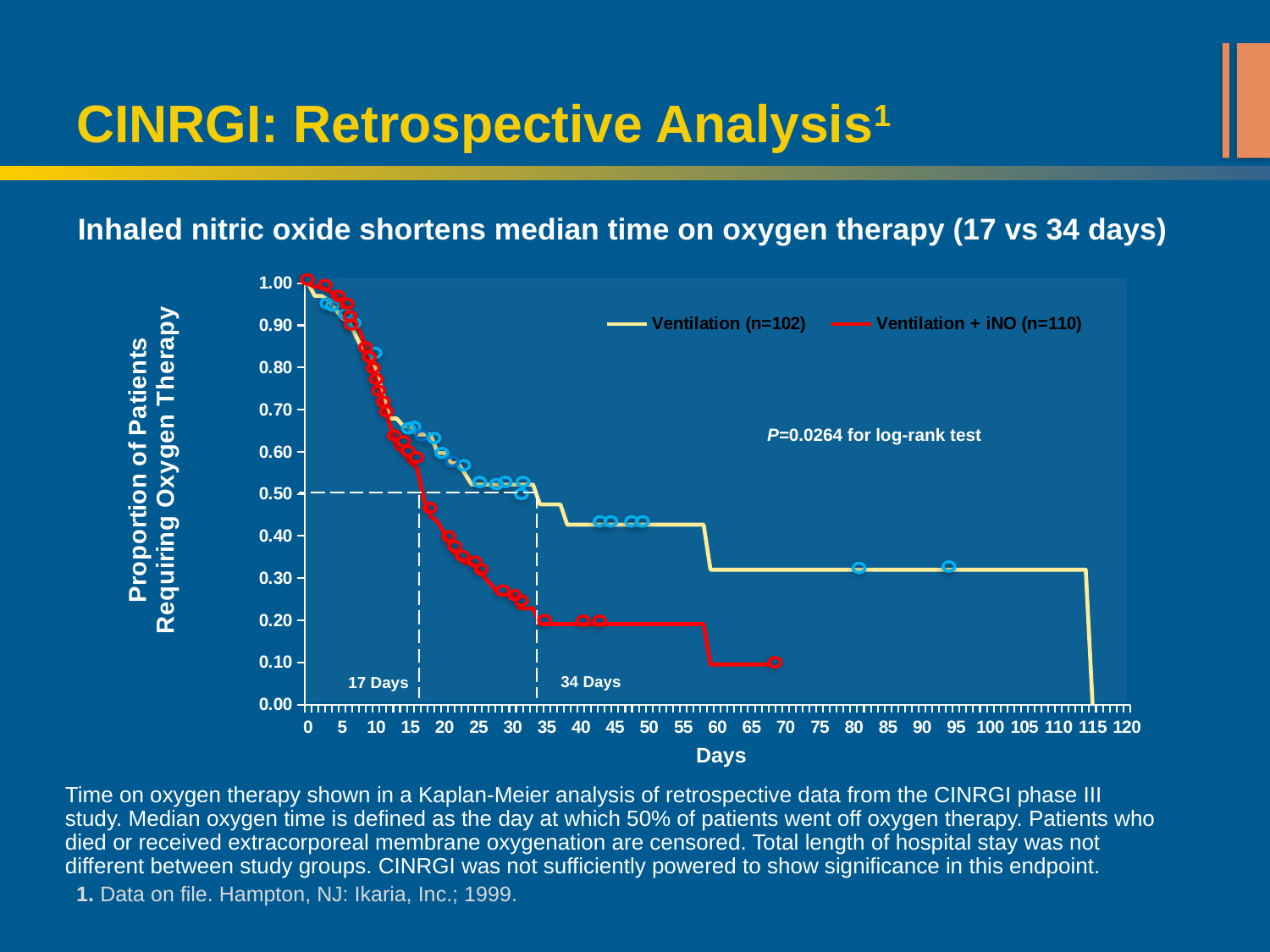
At day 50, which series has the higher proportion of patients requiring oxygen therapy? Ventilation (n=102) What is the median time on oxygen therapy for the Ventilation + iNO group, as labelled on the chart? 17 Days Is the proportion for the Ventilation series at day 40 greater or less than 0.50? less Which group has the shorter median time on oxygen therapy? Ventilation + iNO What is the median time on oxygen therapy for the Ventilation group, as labelled on the chart? 34 Days Do the plotted proportions rise or fall as the number of days increases? Fall What is the P value for the log-rank test shown on the chart? P=0.0264 How many series does the legend list? 2 Is the proportion for the Ventilation + iNO series at day 60 greater or less than 0.20? less What kind of chart is shown on the slide? Line chart How many patients are in the Ventilation + iNO group according to the legend? 110 What is the difference in median time on oxygen therapy between the Ventilation group and the Ventilation + iNO group? 17 days